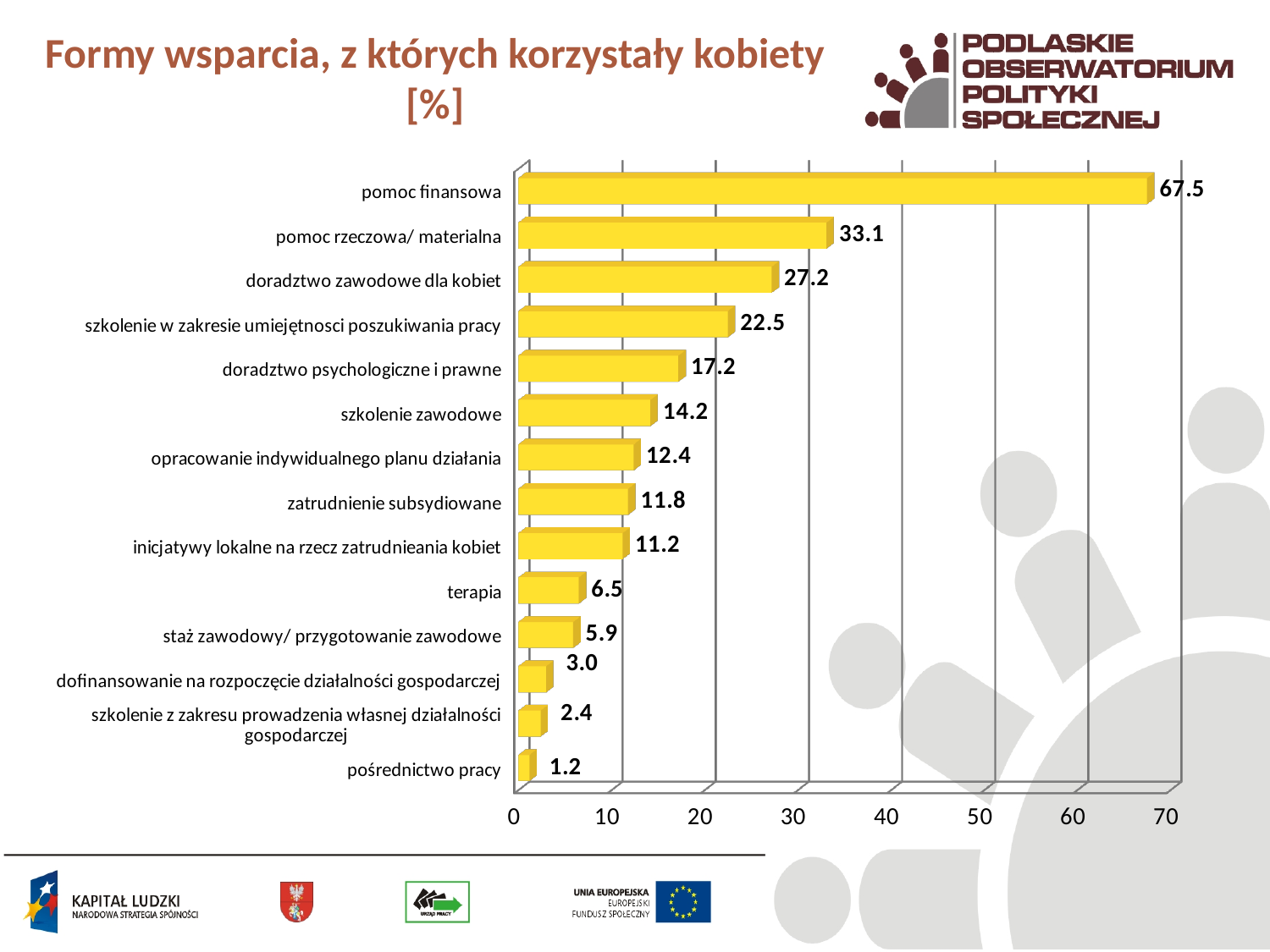
Which category has the highest value? pomoc finansowa Is the value for "pomoc rzeczowa/ materialna" greater or less than 30? greater What is the value for "staż zawodowy/ przygotowanie zawodowe"? 5.9 What is the value for "pomoc finansowa"? 67.5 What is the difference between the values for "pomoc finansowa" and "pomoc rzeczowa/ materialna"? 34.4 What is the value for "szkolenie zawodowe"? 14.2 What is the value for "terapia"? 6.5 What is the title of the chart? Formy wsparcia, z których korzystały kobiety [%] What kind of chart is shown on the slide? bar chart Which is larger: the value for "doradztwo zawodowe dla kobiet" or the value for "szkolenie w zakresie umiejętnosci poszukiwania pracy"? doradztwo zawodowe dla kobiet How many categories are shown in the chart? 14 Which category has the lowest value? pośrednictwo pracy